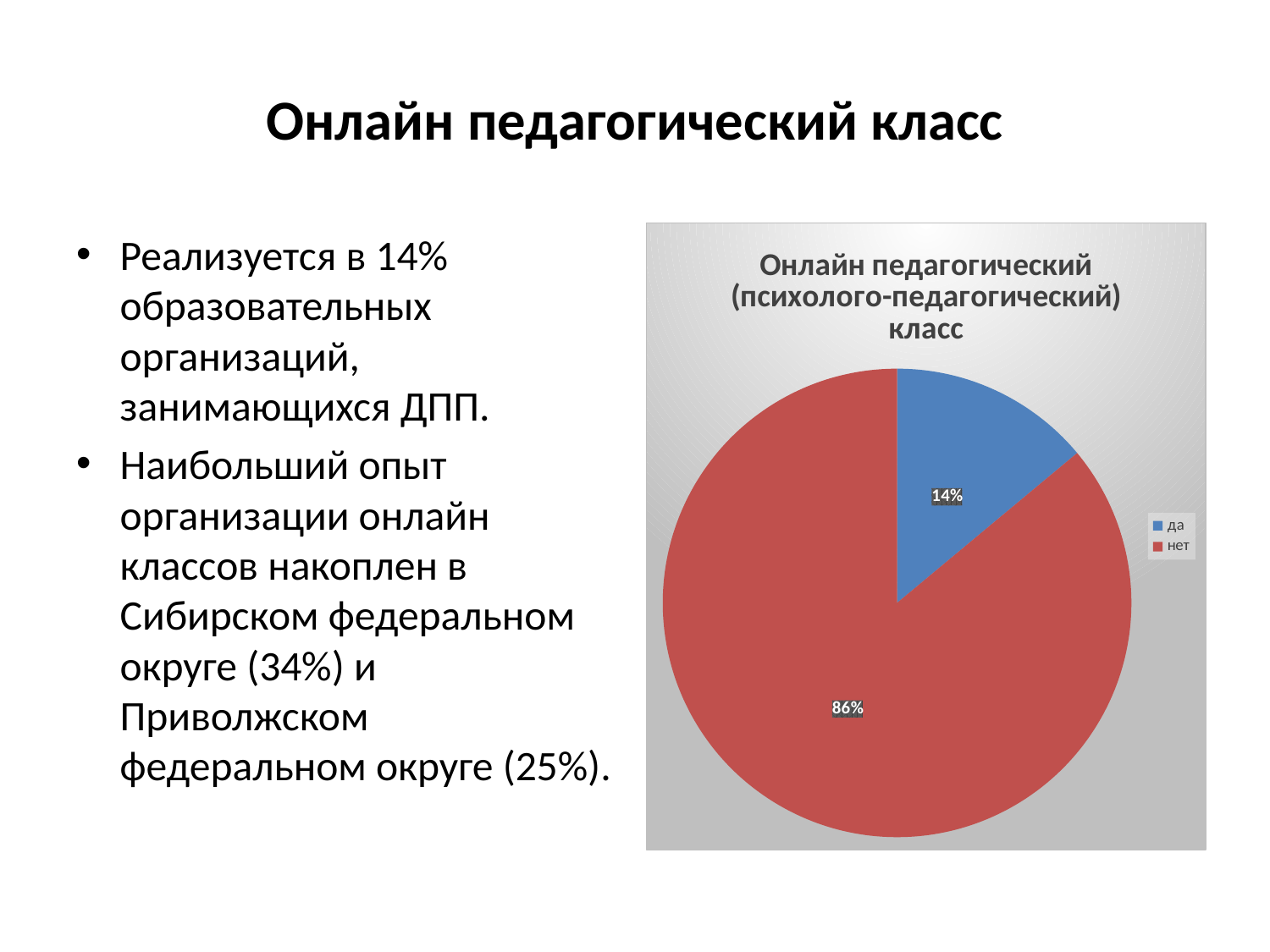
What colour is the "да" slice in the pie chart? blue Which slice is the smallest in the pie chart? да How many entries does the legend list? 2 What is the difference between the "нет" and "да" shares? 72% How many slices does the pie chart have? 2 What share of the pie does the "да" slice represent? 14% What is the title of the chart? Онлайн педагогический (психолого-педагогический) класс What kind of chart is shown on the slide? pie chart Which slice is the largest in the pie chart? нет Which is larger, the "да" slice or the "нет" slice? нет What share of the pie does the "нет" slice represent? 86%